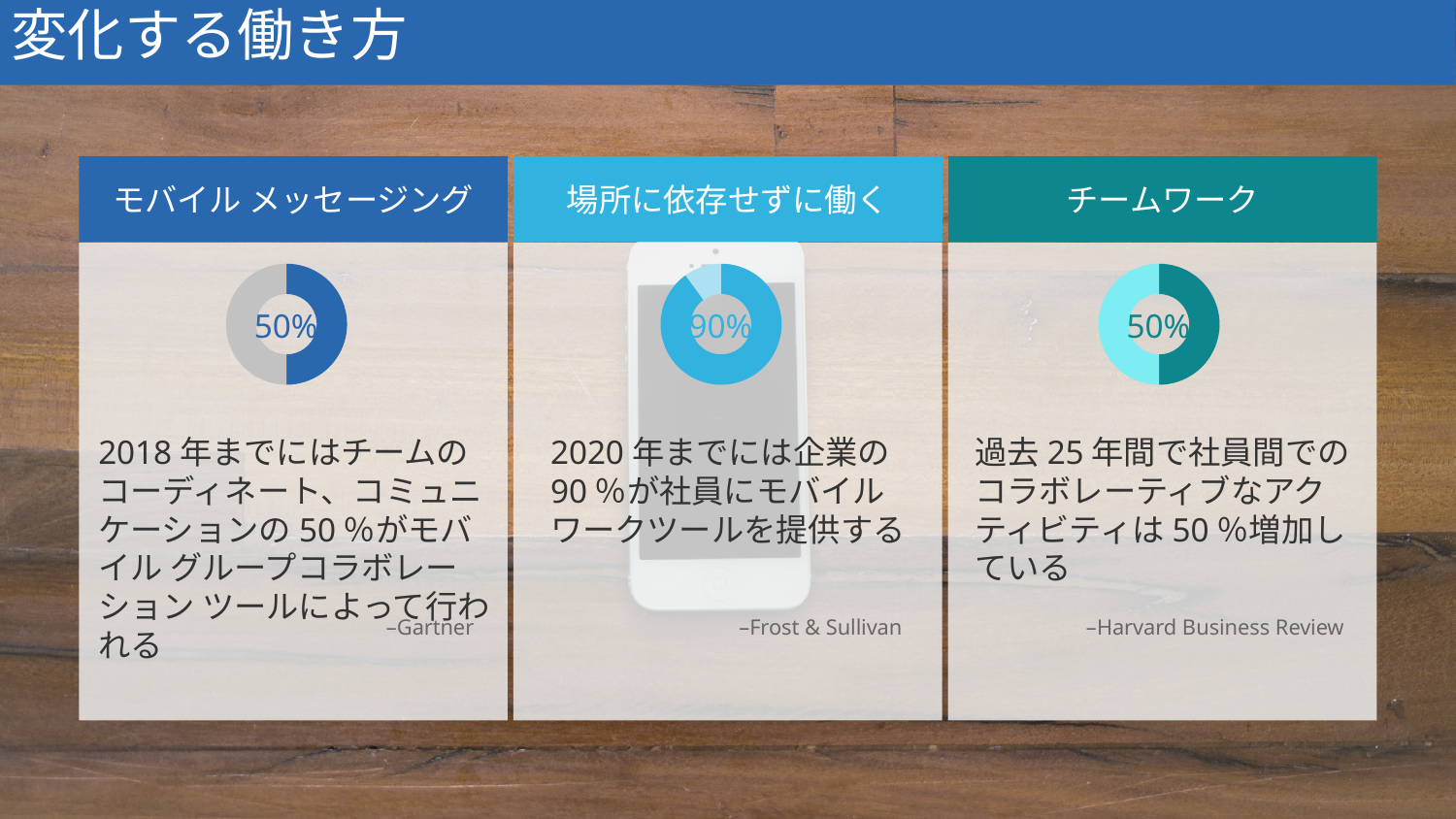
What is the difference between the percentage in the 場所に依存せずに働く donut chart and the percentage in the チームワーク donut chart? 40% Is the percentage in the 場所に依存せずに働く donut chart larger than the percentage in the モバイル メッセージング donut chart? Yes How many donut charts are on the slide? 3 What kind of chart is used in the モバイル メッセージング panel? Donut chart In the 場所に依存せずに働く donut chart, what share of the ring is filled by the highlighted segment? 90% Which source is cited below the 場所に依存せずに働く donut chart? Frost & Sullivan Which source is cited below the チームワーク donut chart? Harvard Business Review Which panel's donut chart shows the highest percentage? 場所に依存せずに働く What value is shown in the centre of the donut chart in the モバイル メッセージング panel? 50% What value is shown in the centre of the donut chart in the 場所に依存せずに働く panel? 90% What value is shown in the centre of the donut chart in the チームワーク panel? 50% Do the モバイル メッセージング and チームワーク donut charts show the same percentage? Yes